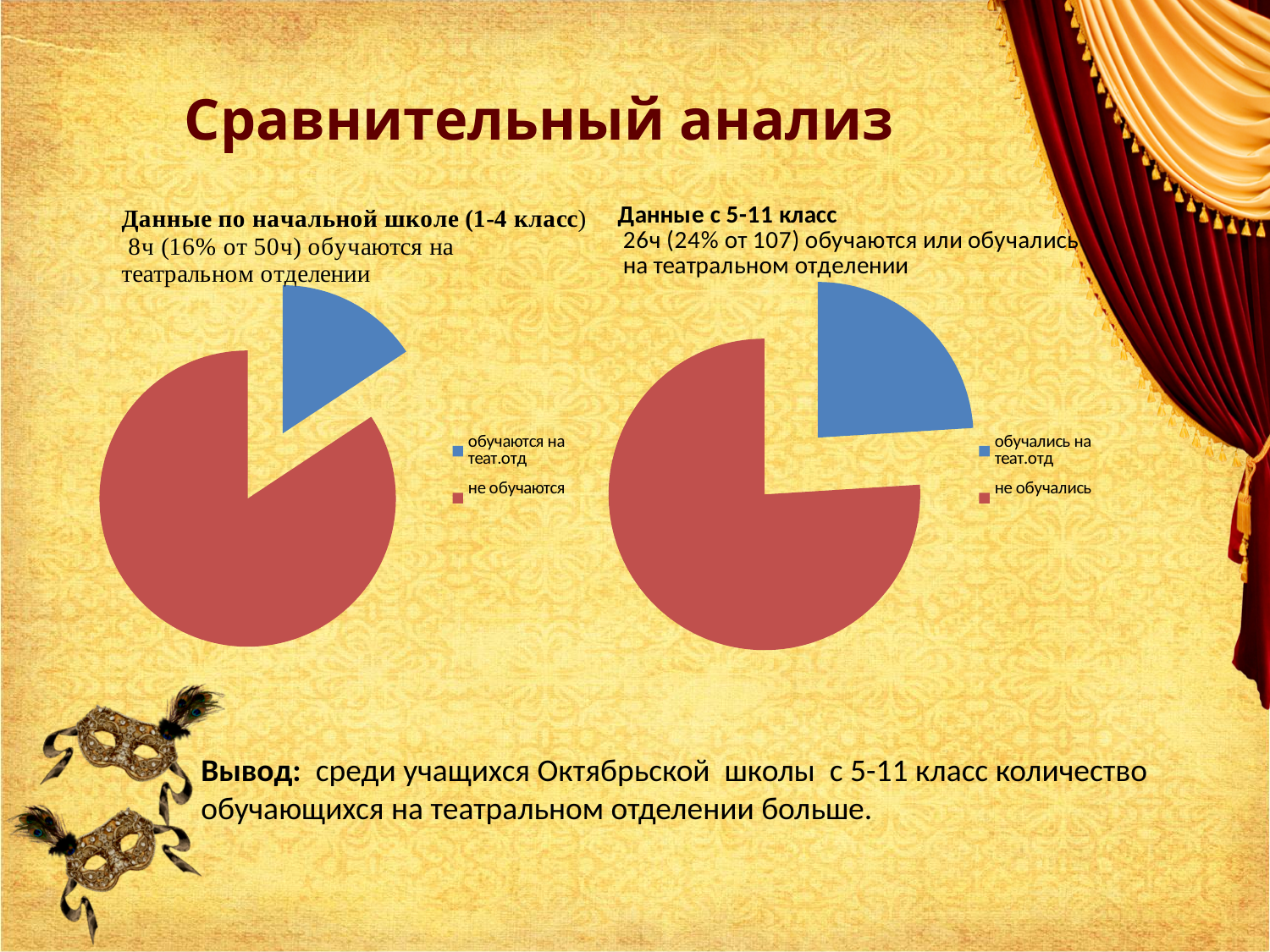
In the left chart (1-4 класс), which slice is the smallest? обучаются на теат.отд What kind of chart is the right chart, 'Данные с 5-11 класс'? pie chart In the left chart (1-4 класс), how many entries does the legend list? 2 In the right chart (5-11 класс), which slice is the largest? не обучались In the right chart (5-11 класс), what share of the pie is the slice 'обучались на теат.отд'? 24% In the left chart (1-4 класс), how many students are shown as studying in the theatre department? 8ч What kind of chart is the left chart, 'Данные по начальной школе (1-4 класс)'? pie chart In the left chart (1-4 класс), which slice is the largest? не обучаются In the right chart (5-11 класс), how many slices does the pie have? 2 In the left chart (1-4 класс), what share of the pie is the slice 'обучаются на теат.отд'? 16% In the right chart (5-11 класс), what colour is the slice 'не обучались'? red Which chart has the larger blue slice for students in the theatre department: the left chart (1-4 класс) or the right chart (5-11 класс)? the right chart (5-11 класс)